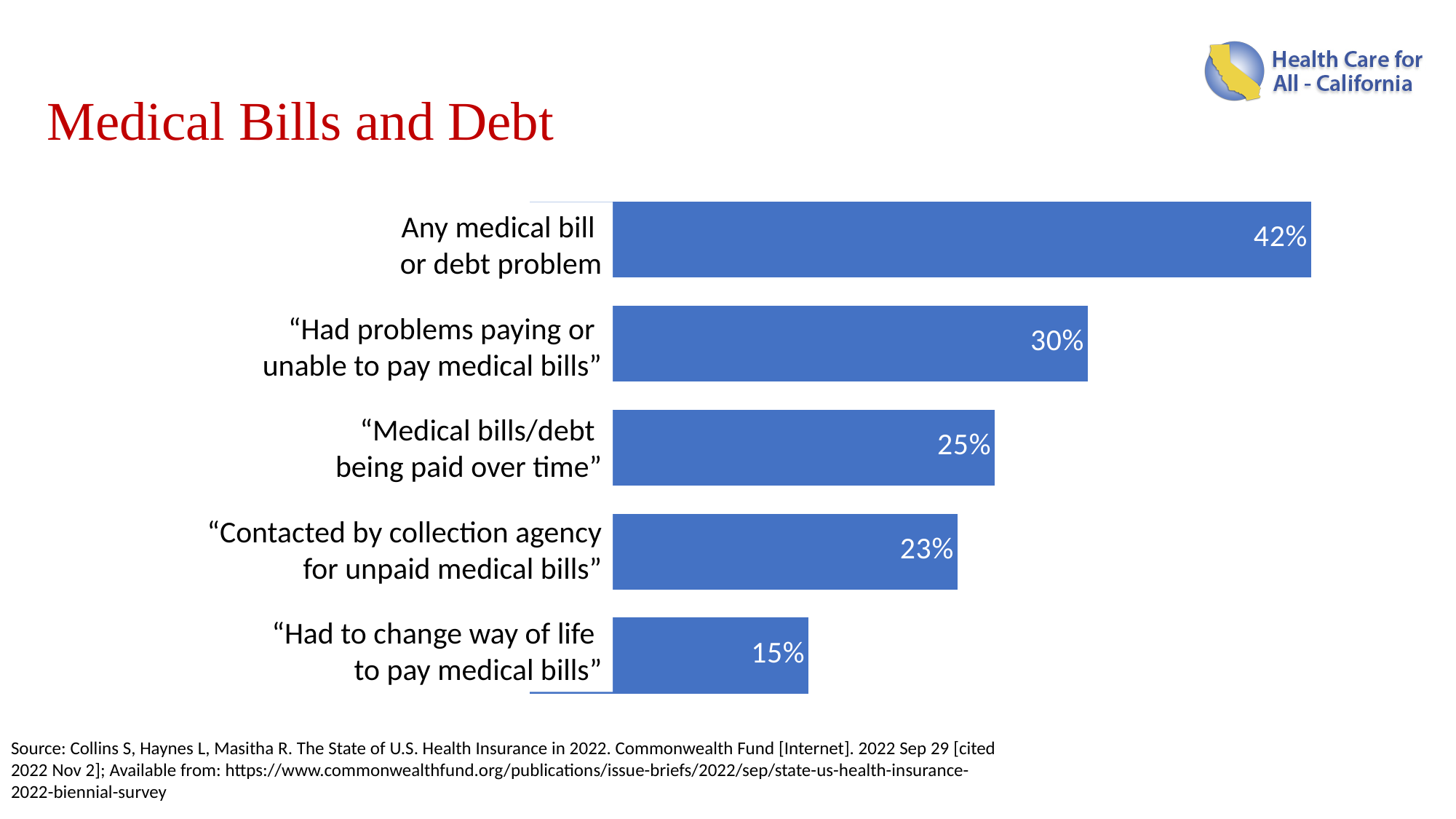
What is the difference between "Medical bills/debt being paid over time" and "Had to change way of life to pay medical bills"? 10% What is the value for "Medical bills/debt being paid over time"? 25% Which category has the highest value? Any medical bill or debt problem How many categories are shown in the chart? 5 What kind of chart is shown on the slide? Bar chart Which category has the lowest value? Had to change way of life to pay medical bills What is the value for "Any medical bill or debt problem"? 42% What is the difference between "Any medical bill or debt problem" and "Had problems paying or unable to pay medical bills"? 12% Which is larger: "Had problems paying or unable to pay medical bills" or "Contacted by collection agency for unpaid medical bills"? Had problems paying or unable to pay medical bills What is the value for "Had to change way of life to pay medical bills"? 15% What is the value for "Contacted by collection agency for unpaid medical bills"? 23% What is the value for "Had problems paying or unable to pay medical bills"? 30%